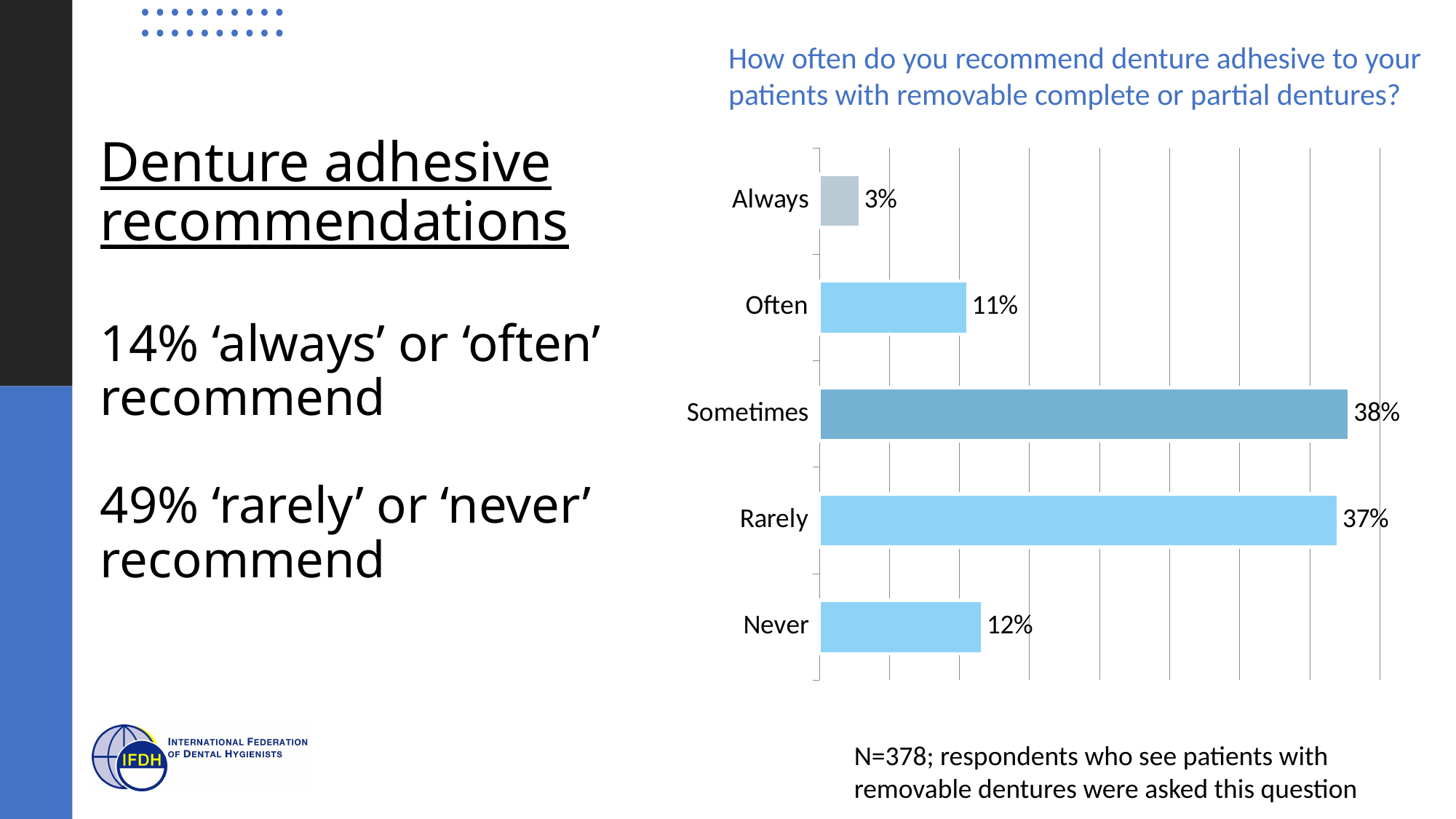
What kind of chart is shown on the slide? Bar chart How many categories are shown in the chart? 5 What is the difference between the 'Rarely' and 'Never' values? 25% What percentage is shown for 'Never'? 12% Which is larger, the value for 'Often' or the value for 'Never'? Never Which category has the highest value? Sometimes What percentage of respondents said they 'Sometimes' recommend denture adhesive? 38% What is the value for 'Often'? 11% What is the sample size (N) stated below the chart? N=378 What is the combined value of 'Always' and 'Often'? 14% Which category has the lowest value? Always What is the value shown for 'Always'? 3%